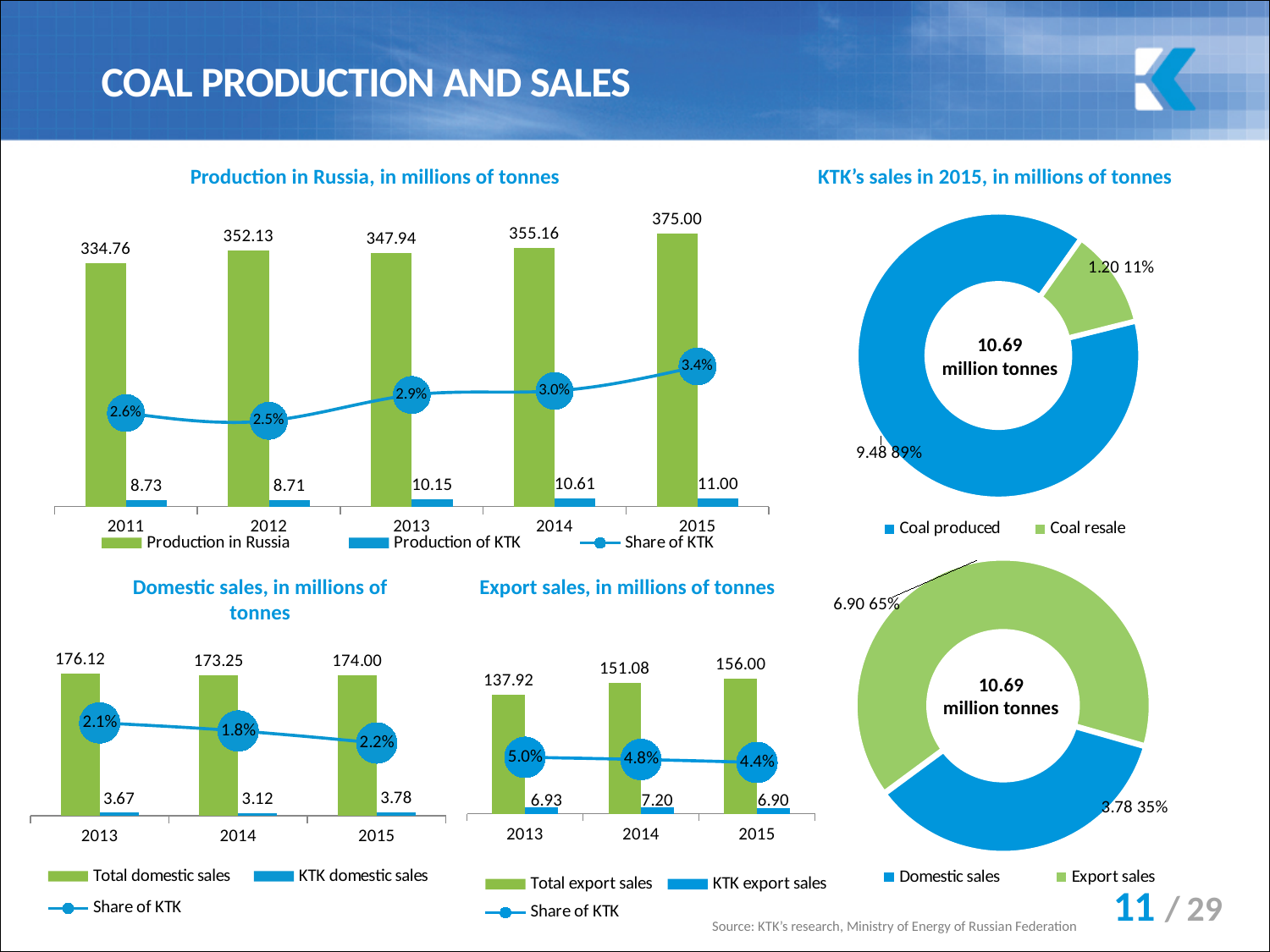
In the 'KTK's sales in 2015, in millions of tonnes' donut chart, what share does Coal resale have? 11% In the 'Domestic sales, in millions of tonnes' chart, which year has the highest Total domestic sales? 2013 In the 'Domestic sales, in millions of tonnes' chart, what is the value of KTK domestic sales in 2014? 3.12 In the 'Production in Russia, in millions of tonnes' chart, what is the difference between Production of KTK in 2015 and in 2014? 0.39 In the 'Production in Russia, in millions of tonnes' chart, what is the Share of KTK in 2012? 2.5% In the 'Production in Russia, in millions of tonnes' chart, which year has the lowest Production in Russia? 2011 In the bottom-right donut chart showing Domestic sales and Export sales, what share does Export sales have? 65% In the 'KTK's sales in 2015, in millions of tonnes' donut chart, what is the value for Coal produced? 9.48 In the 'Production in Russia, in millions of tonnes' chart, how many series does the legend list? 3 In the 'Export sales, in millions of tonnes' chart, do the Total export sales values rise or fall from 2013 to 2015? rise In the 'Production in Russia, in millions of tonnes' chart, what is the Production of KTK in 2013? 10.15 In the 'Production in Russia, in millions of tonnes' chart, what is the value of Production in Russia for 2015? 375.00